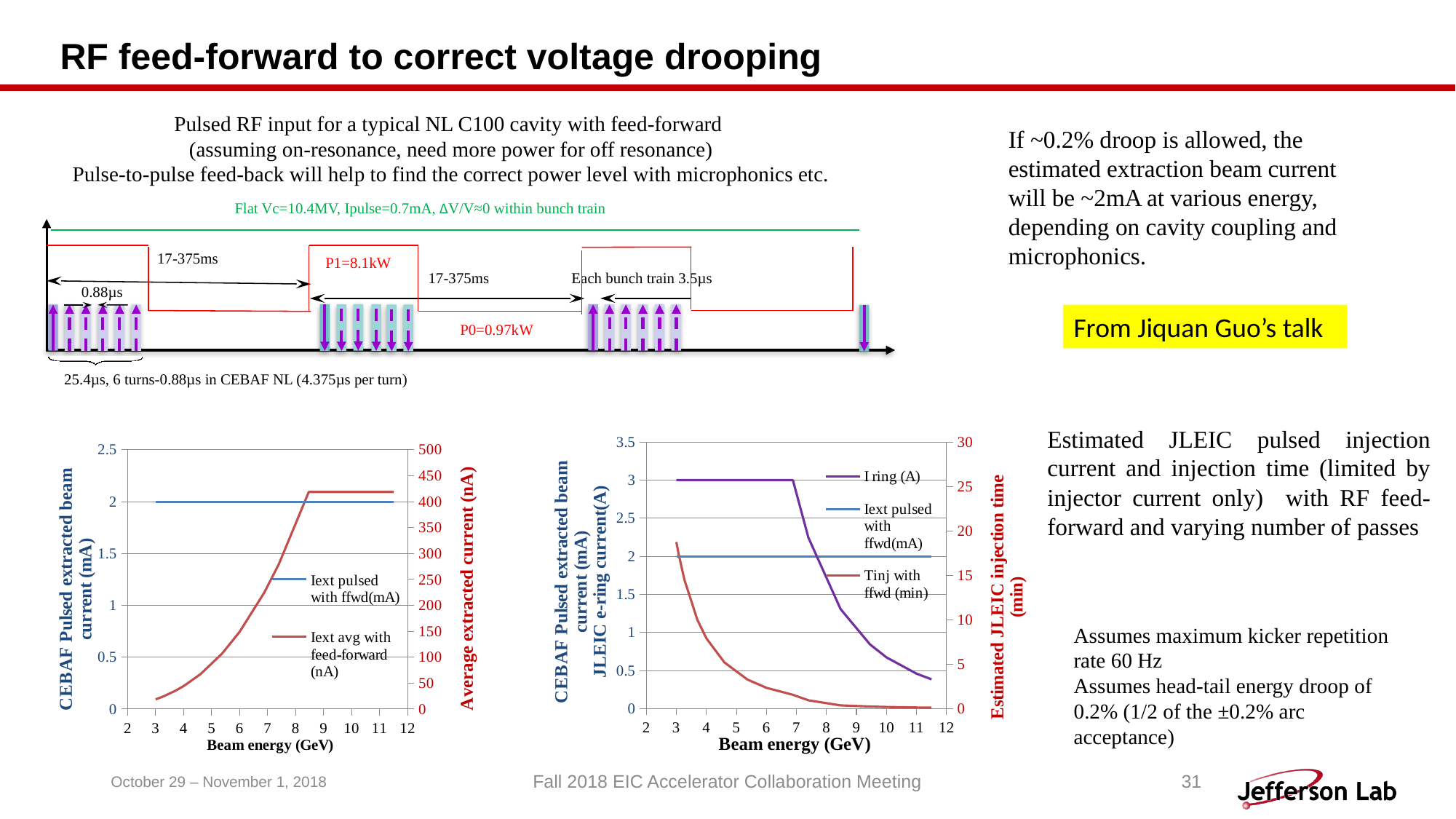
How many series does the legend of the left chart (with the Average extracted current axis) list? 2 In the left chart, what is the value of the 'Iext pulsed with ffwd(mA)' series across the beam energy range? 2 In the right chart, what is the value of 'I ring (A)' at 5 GeV? 3 How many series does the legend of the right chart (with the JLEIC injection time axis) list? 3 What is the x-axis title of the right chart? Beam energy (GeV) In the right chart, is the value of 'Tinj with ffwd (min)' at 3 GeV greater or less than 15? greater What kind of chart is the left chart at the bottom of the slide? line chart In the right chart, does 'Tinj with ffwd (min)' rise or fall as beam energy increases? fall In the left chart, does 'Iext avg with feed-forward (nA)' rise or fall as beam energy increases from 3 to 8 GeV? rise In the left chart, is the value of 'Iext avg with feed-forward (nA)' at 10 GeV greater or less than 400? greater In the left chart, is the value of 'Iext avg with feed-forward (nA)' at 4 GeV greater or less than 100? less In the right chart, at 3 GeV, which is larger: 'I ring (A)' or 'Iext pulsed with ffwd(mA)'? I ring (A)